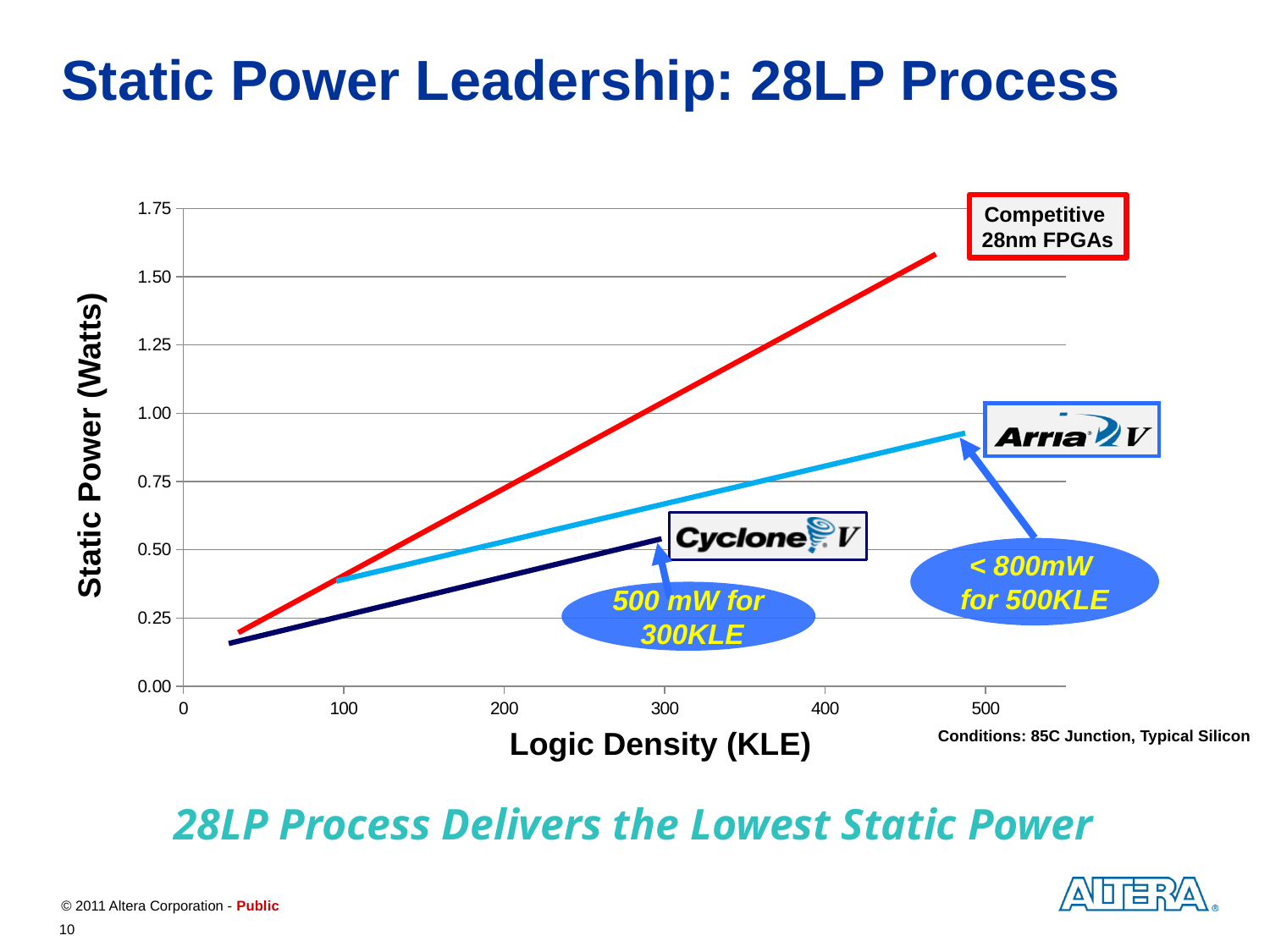
How many lines (series) are plotted on the chart? 3 Is the static power of the Competitive 28nm FPGAs line at 400 KLE greater or less than 1.00 Watts? greater What is the title of the y axis? Static Power (Watts) What kind of chart is shown on the slide? line chart Which series has the lowest static power across the plotted logic densities? Cyclone V According to the callout on the chart, what is the static power of Cyclone V at 300 KLE? 500 mW What conditions are stated for the chart data? 85C Junction, Typical Silicon Do the static power values rise or fall as logic density increases? rise At 300 KLE, which has higher static power: Arria V or Cyclone V? Arria V Is the static power of the Arria V line at 500 KLE greater or less than 1.00 Watts? less Which series has the highest static power at 400 KLE? Competitive 28nm FPGAs Is the static power of the Cyclone V line at 300 KLE greater or less than 0.75 Watts? less